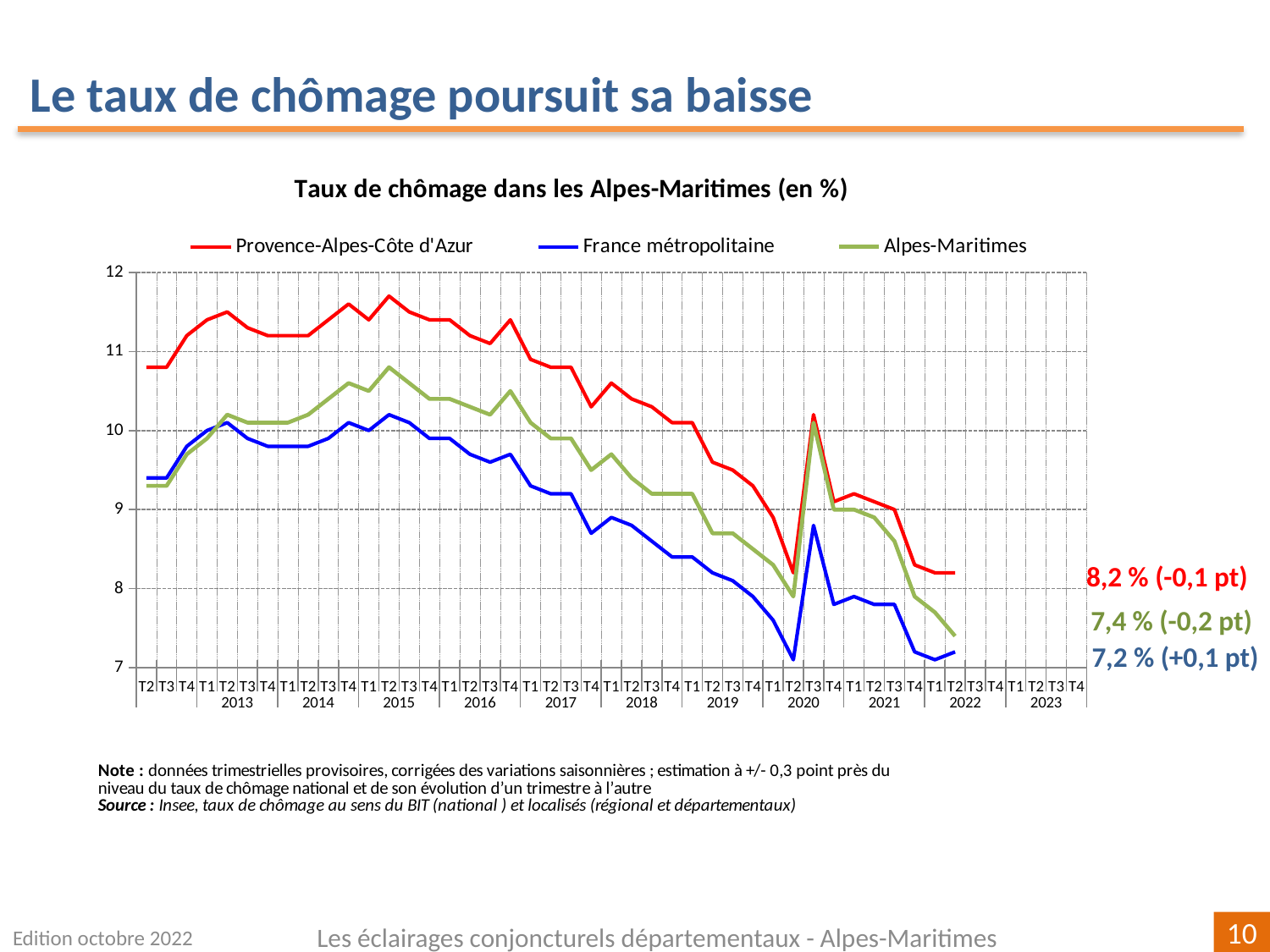
How many series does the legend list? 3 What is the latest unemployment rate shown for France métropolitaine? 7,2 % By how much did the Alpes-Maritimes rate change compared with the previous quarter, according to the annotation? -0,2 pt What is the difference between the latest rates for Provence-Alpes-Côte d'Azur and France métropolitaine? 1,0 pt At the latest point, which is higher: Provence-Alpes-Côte d'Azur or Alpes-Maritimes? Provence-Alpes-Côte d'Azur Is the value for Provence-Alpes-Côte d'Azur in T2 2015 greater or less than 11? greater What kind of chart is shown on the slide? line chart What is the latest unemployment rate shown for Alpes-Maritimes? 7,4 % Is the value for France métropolitaine in T2 2020 greater or less than 8? less Which series has the lowest value at the end of the chart? France métropolitaine What is the latest unemployment rate shown for Provence-Alpes-Côte d'Azur? 8,2 % Overall, do the unemployment rates rise or fall from 2013 to 2022? fall